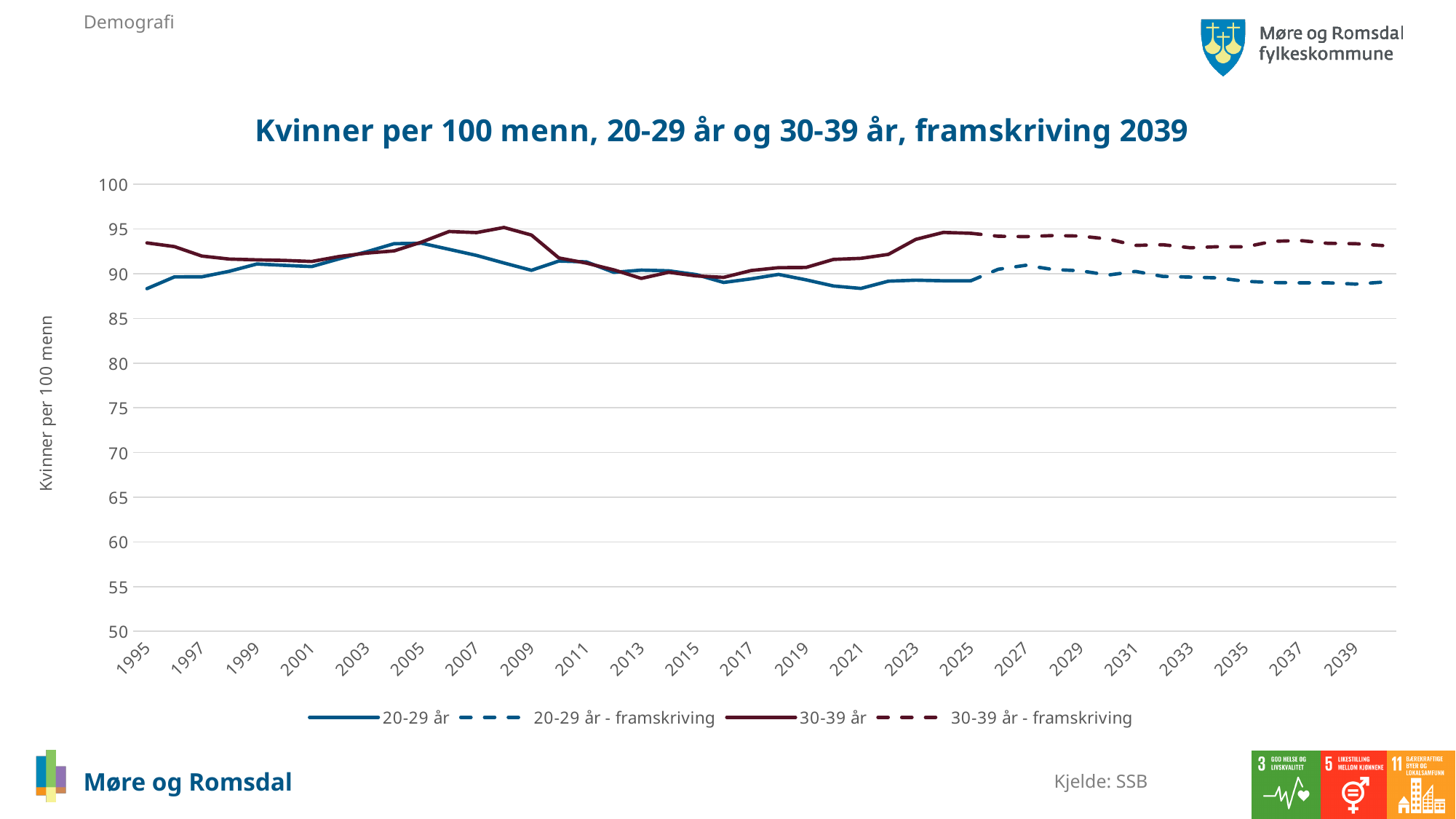
Is the value for 20-29 år in 2021 greater or less than 90? less How many series does the legend list? 4 Does the 20-29 år - framskriving series rise or fall from 2027 to 2039? fall Is the value for 20-29 år in 1995 greater or less than 90? less What is the title of the chart? Kvinner per 100 menn, 20-29 år og 30-39 år, framskriving 2039 What kind of chart is shown on the slide? Line chart Is the value for 20-29 år - framskriving in 2039 greater or less than 90? less In 1995, which series has the higher value: 20-29 år or 30-39 år? 30-39 år In 2023, which series has the higher value: 20-29 år or 30-39 år? 30-39 år What is the label on the vertical axis? Kvinner per 100 menn